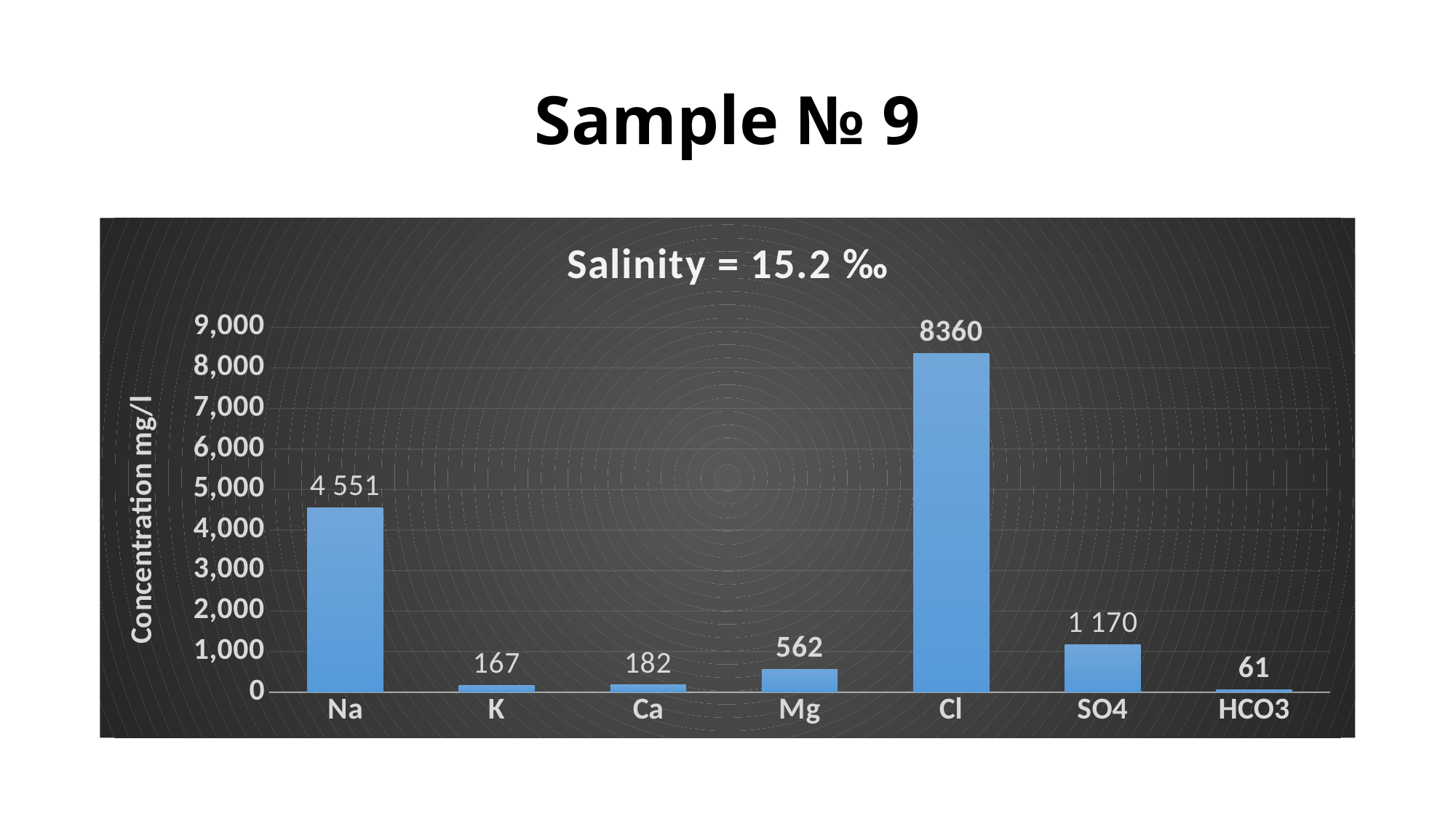
What is the concentration of Cl? 8360 How many ions are shown on the x axis? 7 What is the difference between the concentrations of Ca and K? 15 What is the difference between the concentrations of Cl and Na? 3809 What is the concentration of HCO3? 61 What is the concentration of Na? 4 551 What is the concentration of SO4? 1 170 Which ion has the highest concentration? Cl Which ion has the lowest concentration? HCO3 What type of chart is shown? Bar chart What is the chart's title? Salinity = 15.2 ‰ Which has a higher concentration, Mg or SO4? SO4